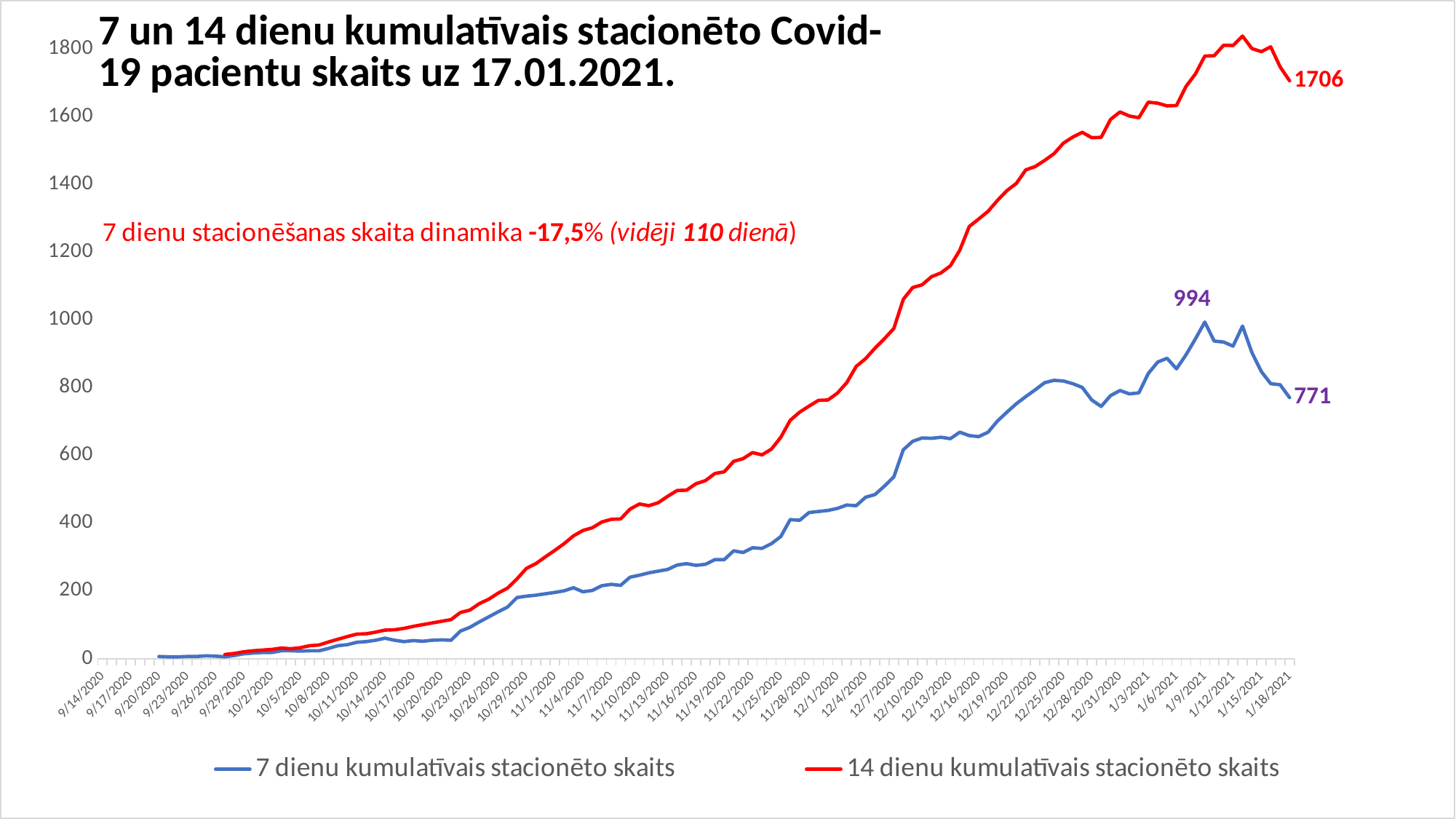
Is the value of the 14-day series on 12/1/2020 greater or less than 1000? less What is the labelled peak value of the '7 dienu kumulatīvais stacionēto skaits' series? 994 How much did the 7-day series fall from its labelled peak of 994 to its final labelled value of 771? 223 What kind of chart is shown on the slide? line chart What is the last labelled value of the '7 dienu kumulatīvais stacionēto skaits' series? 771 Is the value of the 14-day series on 1/9/2021 greater or less than 1600? greater At the end of the chart, which series has the higher value: the 7-day or the 14-day cumulative count? 14 dienu kumulatīvais stacionēto skaits Over the whole period from 9/14/2020 to 1/18/2021, do the values of the 14-day series mostly rise or fall? rise Which colour is used for the '7 dienu kumulatīvais stacionēto skaits' series? blue How many series does the legend list? 2 What is the difference between the final labelled values of the 14-day series (1706) and the 7-day series (771)? 935 What is the last labelled value of the '14 dienu kumulatīvais stacionēto skaits' series? 1706